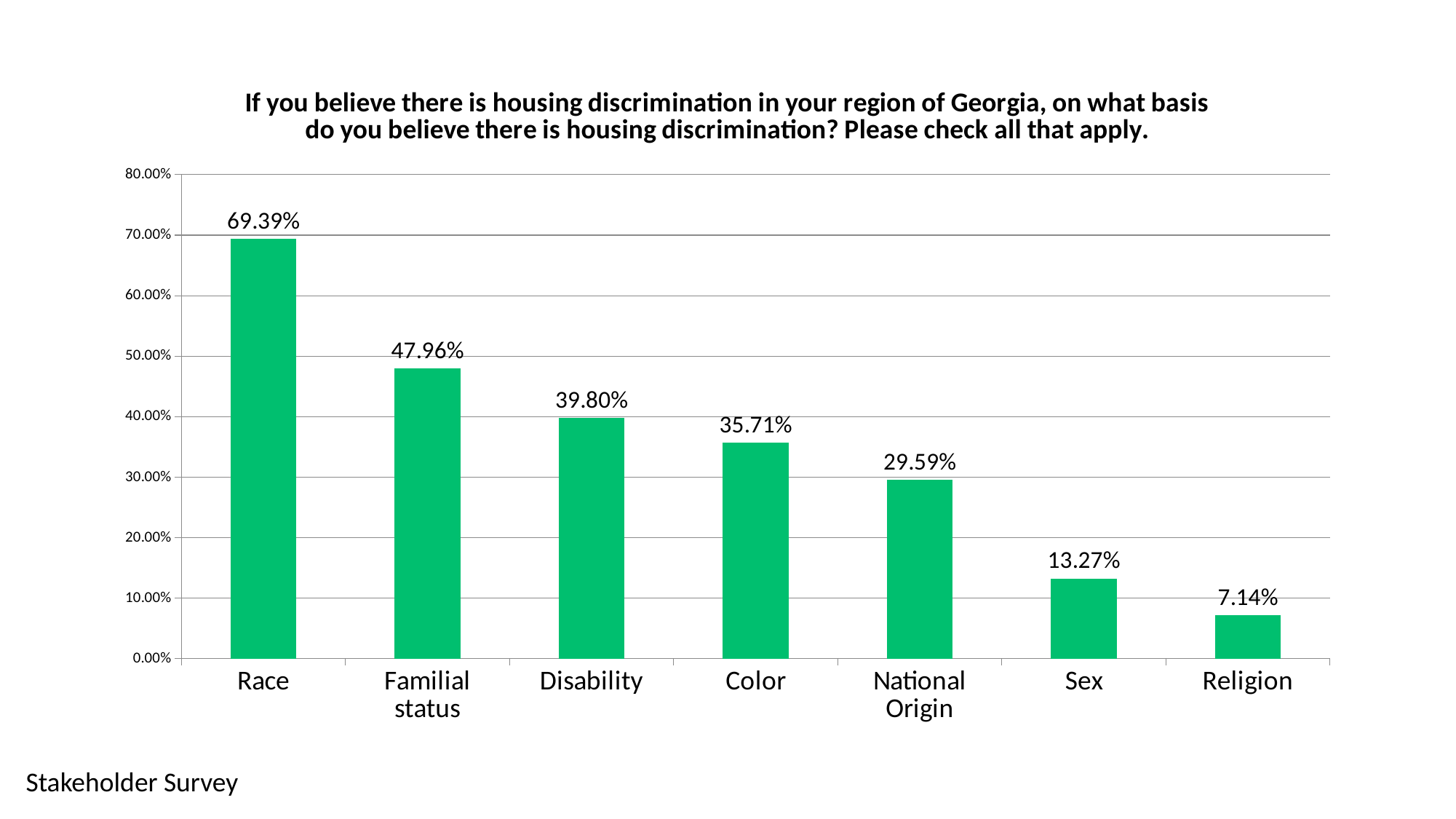
What is the difference between the values for Race and Familial status? 21.43% What kind of chart is shown on the slide? Bar chart What is the value shown for National Origin? 29.59% Do the values rise or fall moving from left to right along the x axis? Fall Is the value for Color greater or less than 30.00%? greater What is the value shown for Familial status? 47.96% Which is larger, the value for Disability or the value for Color? Disability How many categories are shown on the x axis? 7 What percentage of respondents selected Race as a basis for housing discrimination? 69.39% What is the difference between the values for Sex and Religion? 6.13% Which category has the lowest value? Religion Which category has the highest value? Race